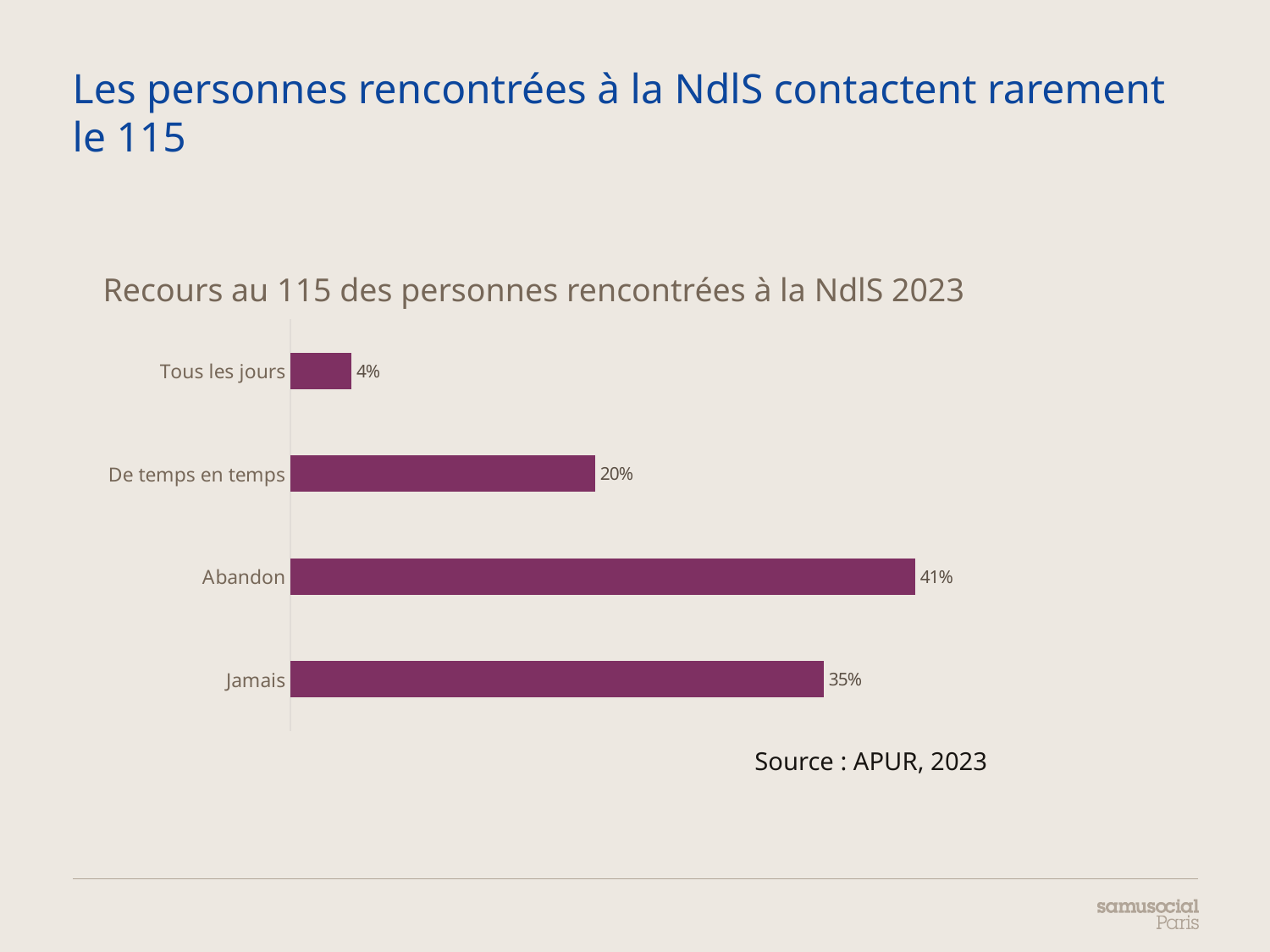
How many categories are shown in the chart? 4 Which category has the lowest value? Tous les jours What is the value for "Jamais"? 35% What kind of chart is shown on the slide? Bar chart What is the difference between the values for "De temps en temps" and "Tous les jours"? 16% What is the value for "Abandon"? 41% Which category has the highest value? Abandon What is the title of the chart? Recours au 115 des personnes rencontrées à la NdlS 2023 What is the value for "Tous les jours"? 4% What is the value for "De temps en temps"? 20% What is the difference between the values for "Abandon" and "Jamais"? 6% Which is larger, the value for "Jamais" or the value for "De temps en temps"? Jamais